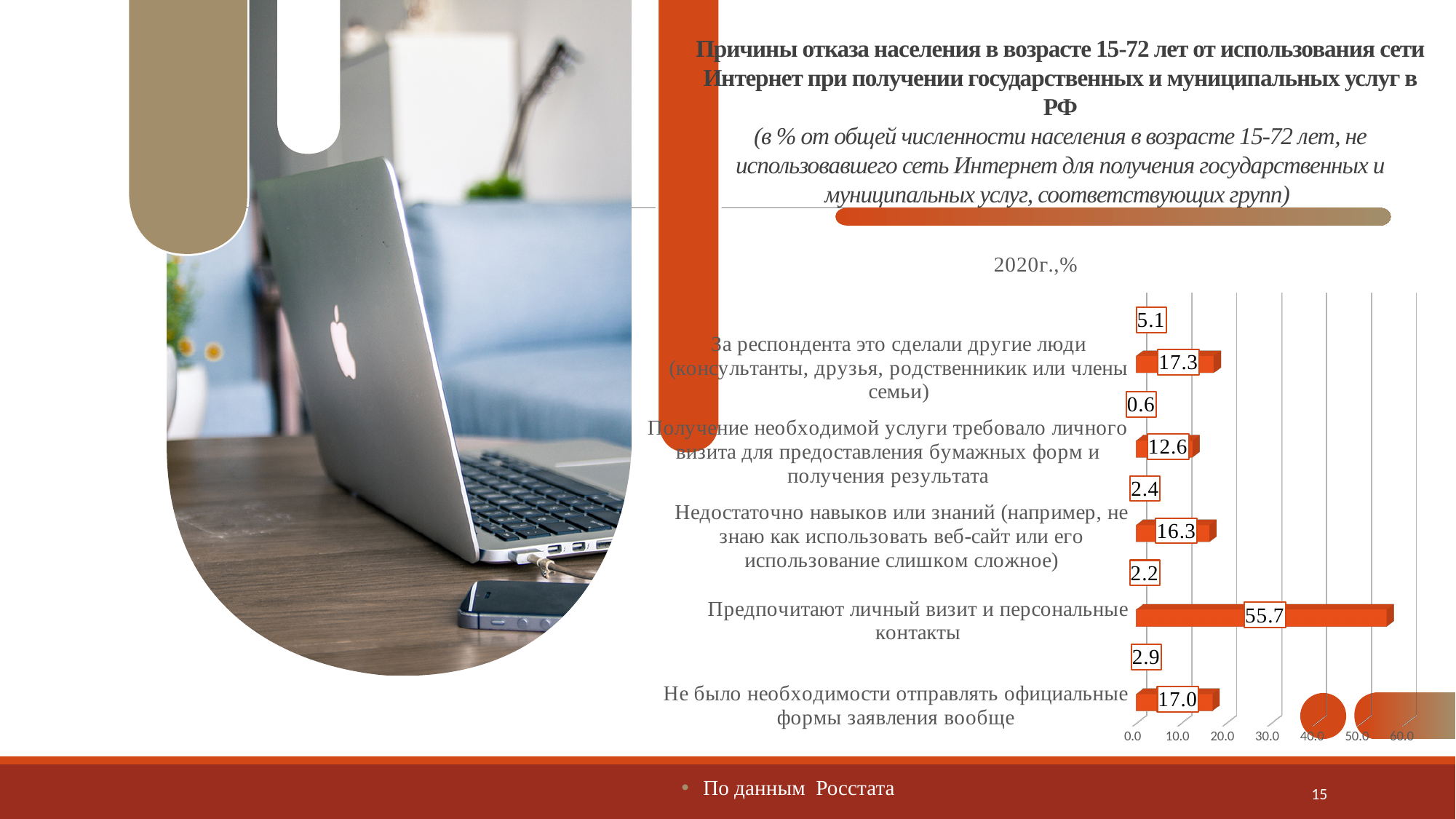
What is the title shown above the chart? 2020г.,% What is the value for "Недостаточно навыков или знаний (например, не знаю как использовать веб-сайт или его использование слишком сложное)"? 16.3 What is the smallest value shown on any bar in the chart? 0.6 What is the value for "Получение необходимой услуги требовало личного визита для предоставления бумажных форм и получения результата"? 12.6 What type of chart is shown on the slide? bar chart What is the value for "Предпочитают личный визит и персональные контакты"? 55.7 Is the value for "Предпочитают личный визит и персональные контакты" greater or less than 50.0? greater How many bars are plotted in the chart? 10 Which is larger: the value for "За респондента это сделали другие люди" or the value for "Недостаточно навыков или знаний"? За респондента это сделали другие люди What is the difference between the value for "Предпочитают личный визит и персональные контакты" and the value for "Не было необходимости отправлять официальные формы заявления вообще"? 38.7 Which category has the highest value in the chart? Предпочитают личный визит и персональные контакты What is the value for "Не было необходимости отправлять официальные формы заявления вообще"? 17.0